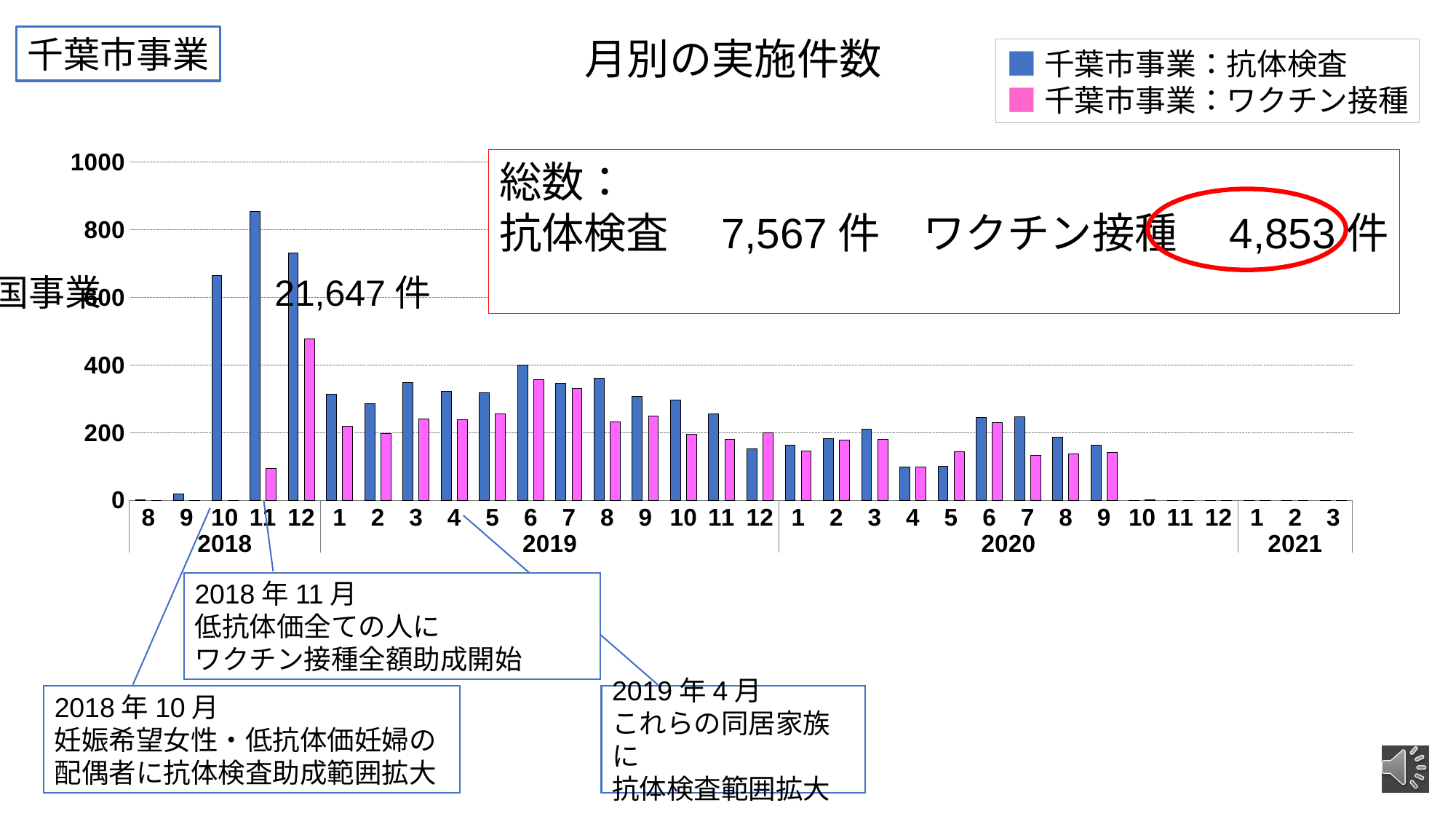
According to the text box, what is the total number of 抗体検査 cases? 7,567 件 According to the text box, what is the total number of ワクチン接種 cases? 4,853 件 In which month is the ワクチン接種 (vaccination) bar highest? 2018年12月 Is the 抗体検査 value for 2020年4月 greater or less than 200? less What kind of chart is shown on the slide? bar chart For 2018年12月, which is larger: the 抗体検査 bar or the ワクチン接種 bar? 抗体検査 Which series is shown in pink in the legend? 千葉市事業：ワクチン接種 What is the title of the chart? 月別の実施件数 How many series does the legend list? 2 Is the 抗体検査 value for 2018年11月 greater or less than 800? greater In which month is the 抗体検査 (antibody test) bar highest? 2018年11月 Is the ワクチン接種 value for 2018年11月 greater or less than 200? less